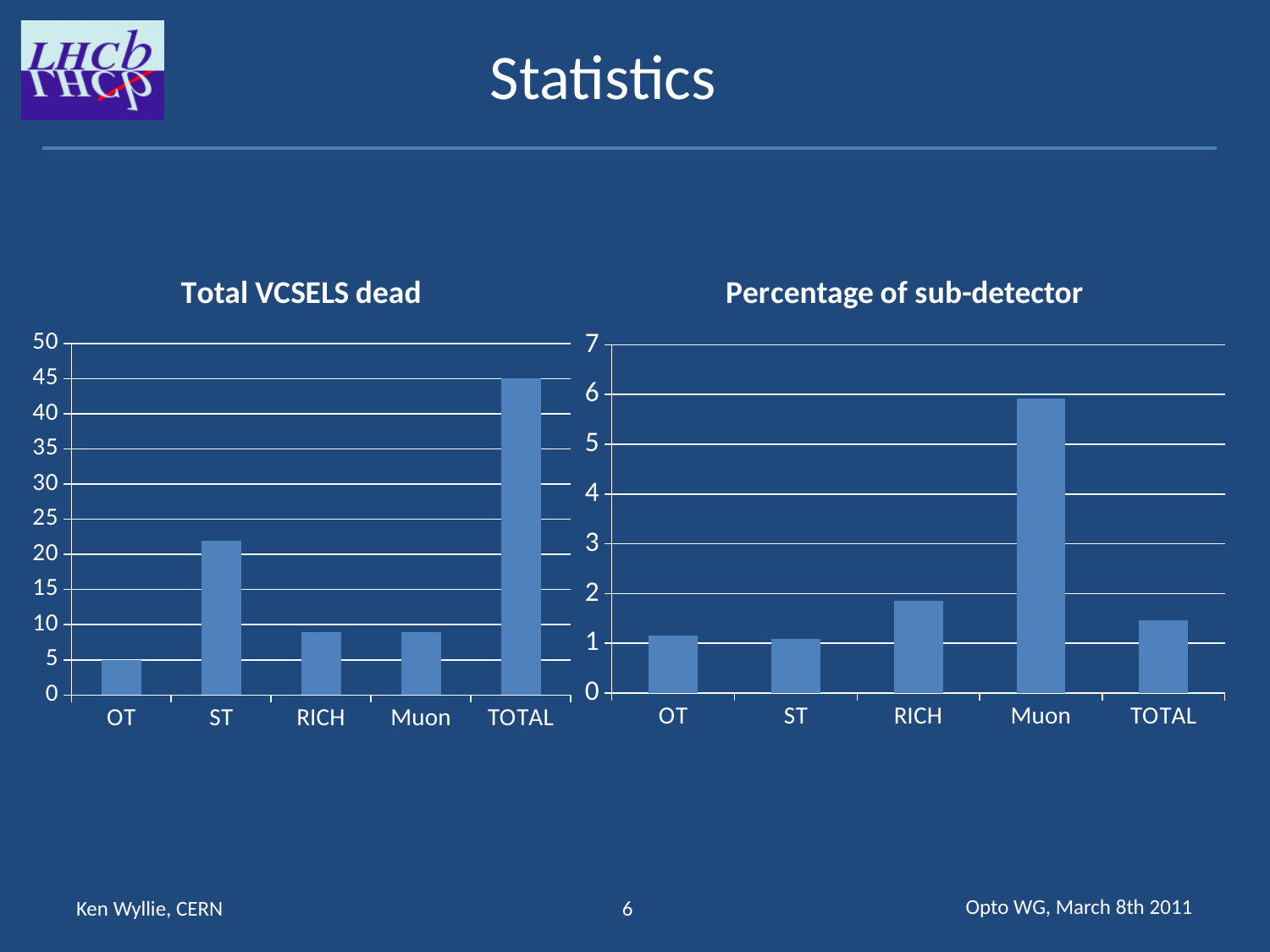
On the 'Percentage of sub-detector' chart, is the value for RICH greater or less than 2? less On the 'Total VCSELS dead' chart, is the value for RICH greater or less than 10? less On the 'Percentage of sub-detector' chart, which is larger, RICH or ST? RICH On the 'Percentage of sub-detector' chart, which category has the highest value? Muon On the 'Total VCSELS dead' chart, which category has the highest value? TOTAL On the 'Total VCSELS dead' chart, what is the value for TOTAL? 45 On the 'Percentage of sub-detector' chart, is the value for Muon greater or less than 5? greater On the 'Total VCSELS dead' chart, what is the value for OT? 5 On the 'Total VCSELS dead' chart, which category has the lowest value? OT How many categories are shown on the 'Percentage of sub-detector' chart? 5 On the 'Total VCSELS dead' chart, which is larger, ST or RICH? ST